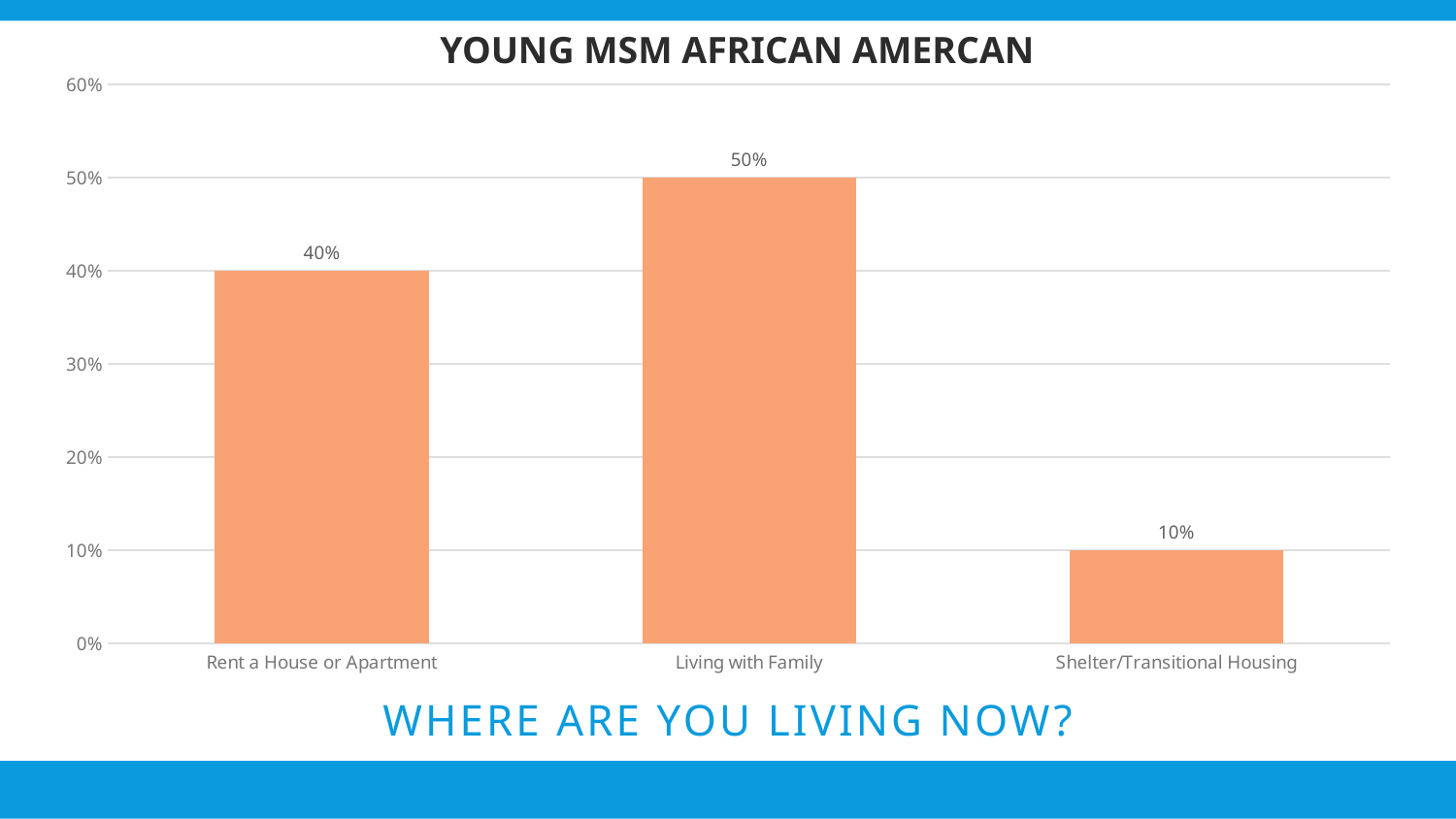
Which category has the highest value? Living with Family Which is larger, the value for Rent a House or Apartment or the value for Shelter/Transitional Housing? Rent a House or Apartment What is the value for Rent a House or Apartment? 40% What is the difference between the values for Rent a House or Apartment and Shelter/Transitional Housing? 30% How many categories are shown on the chart? 3 Is the value for Living with Family greater or less than 30%? greater What is the title of the chart? YOUNG MSM AFRICAN AMERCAN What is the value for Living with Family? 50% What is the difference between the values for Living with Family and Rent a House or Apartment? 10% What kind of chart is shown on the slide? Bar chart Which category has the lowest value? Shelter/Transitional Housing What is the value for Shelter/Transitional Housing? 10%